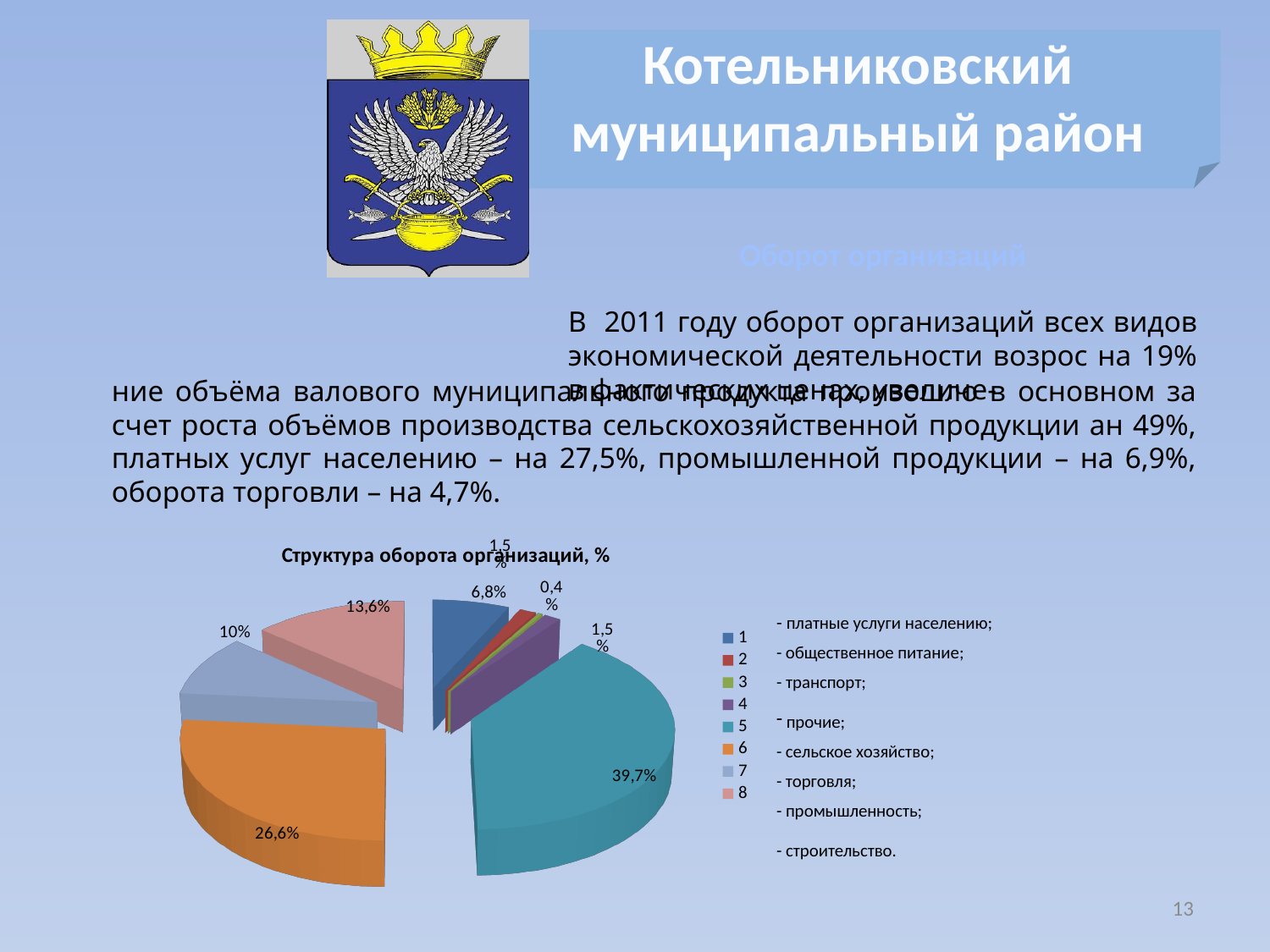
Which legend category has the smallest slice of the pie? 3 What is the value of the largest slice of the pie? 39,7% What is the value of the smallest slice of the pie? 0,4% How many entries does the chart legend list? 8 What is the value of the pink slice (legend category 8)? 13,6% What kind of chart is shown on the slide? pie chart Which legend category has the largest slice of the pie? 5 How many slices does the pie chart have? 8 What is the title of the chart? Структура оборота организаций, % What is the value of the orange slice (legend category 6)? 26,6% What is the difference between the largest slice (39,7%) and the orange slice (26,6%)? 13,1% Which slice is larger: the light blue slice (10%) or the pink slice (13,6%)? the pink slice (13,6%)